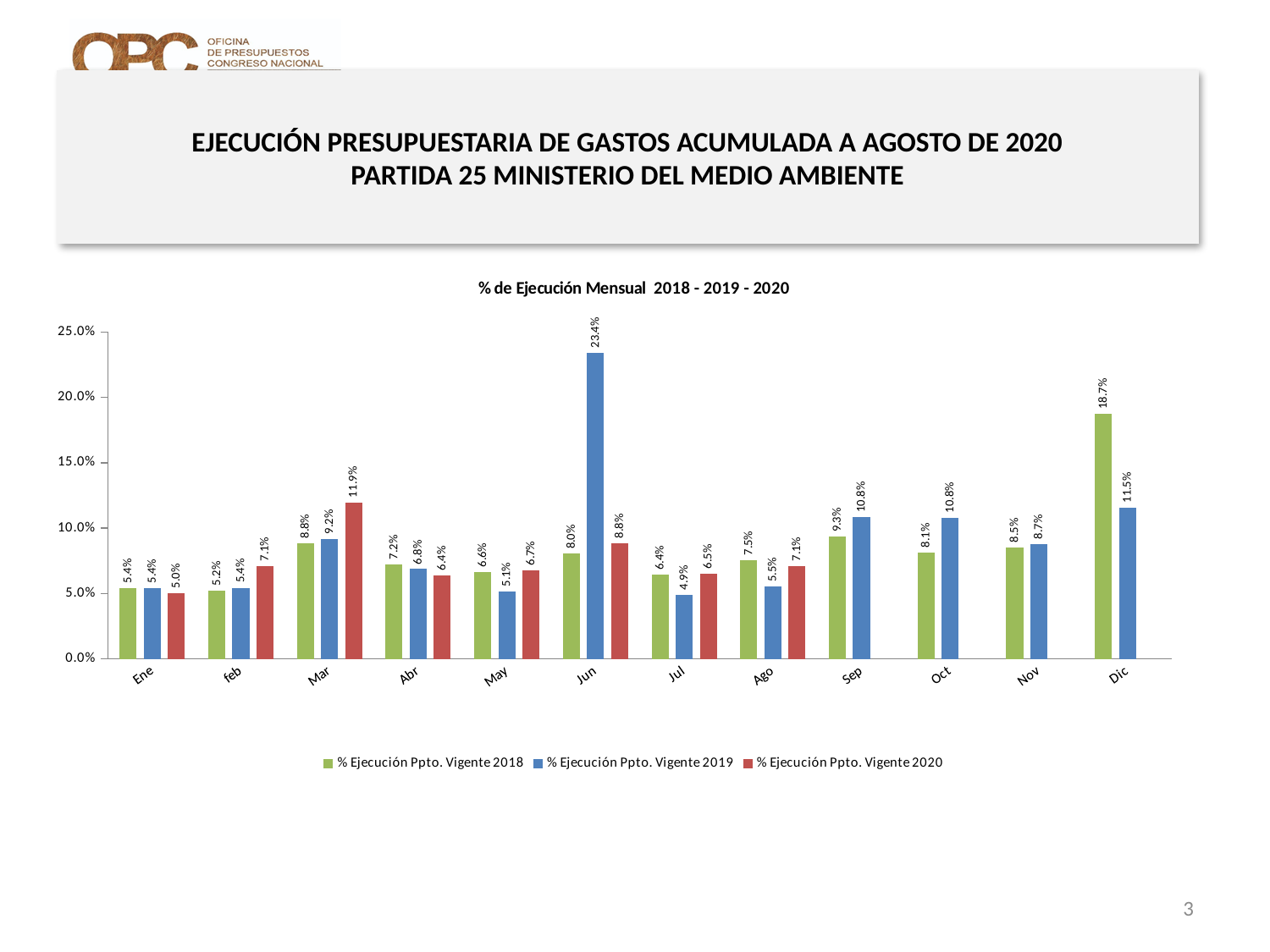
What is the value for % Ejecución Ppto. Vigente 2019 in Jun? 23.4% Which is larger in Mar: the 2018 value or the 2020 value? 2020 value What kind of chart is shown on the slide? Bar chart What is the title of the chart? % de Ejecución Mensual 2018 - 2019 - 2020 Which month has the highest value for % Ejecución Ppto. Vigente 2018? Dic How many series does the legend list? 3 What is the value for % Ejecución Ppto. Vigente 2018 in Dic? 18.7% Which month has the lowest value for % Ejecución Ppto. Vigente 2019? Jul Is the value for % Ejecución Ppto. Vigente 2019 in Jun greater or less than 20.0%? greater What is the value for % Ejecución Ppto. Vigente 2020 in Mar? 11.9% What is the difference between the 2019 and 2018 values in Jun? 15.4% How many months are shown on the x axis? 12